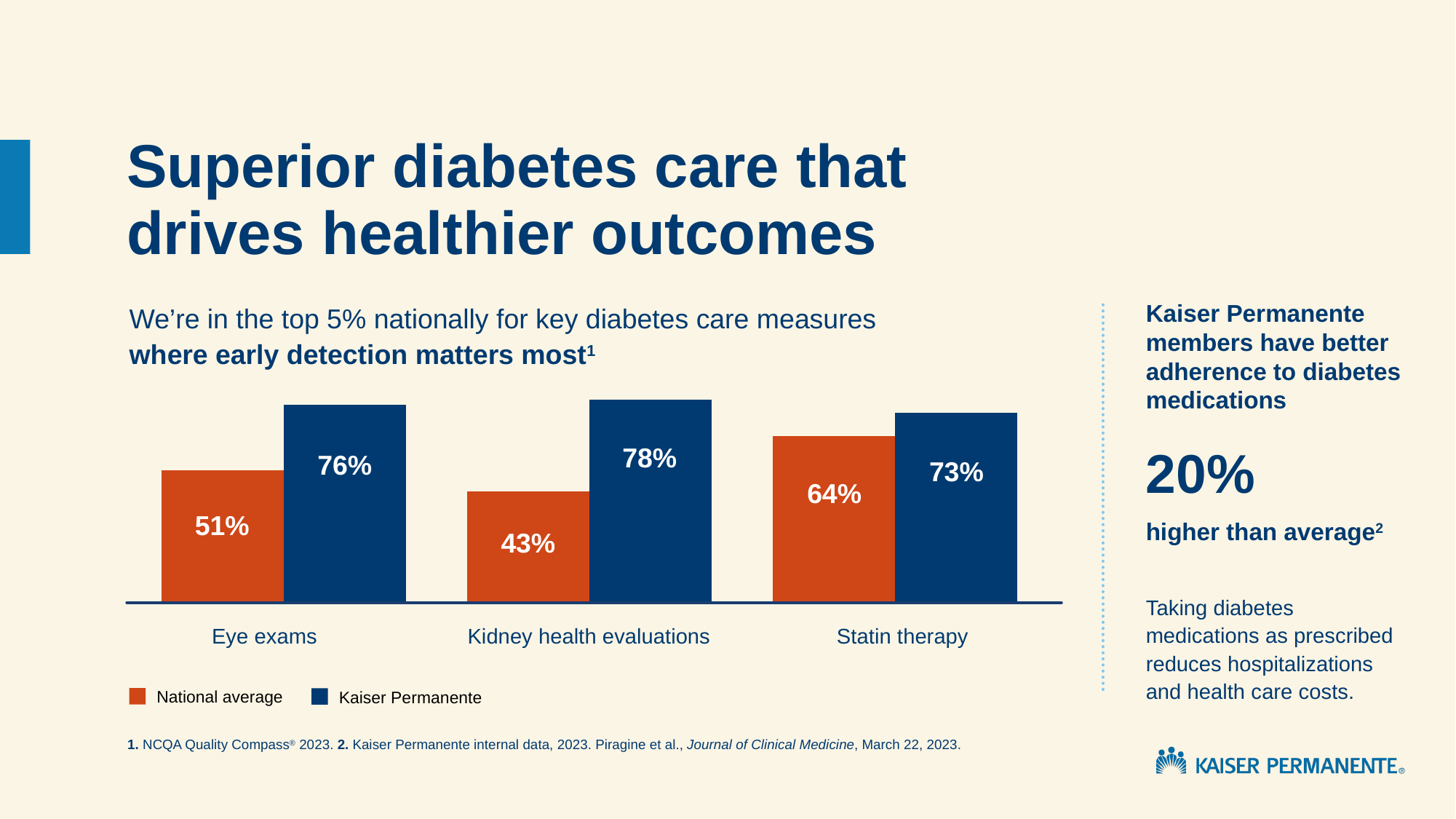
Which category has the highest Kaiser Permanente value? Kidney health evaluations What is the Kaiser Permanente value for Eye exams? 76% What kind of chart is shown on the slide? Bar chart How many categories are shown on the x axis of the chart? 3 Which colour represents the National average series in the chart? Orange What is the National average value for Statin therapy? 64% Which category has the lowest National average value? Kidney health evaluations What is the difference between the Kaiser Permanente and National average values for Kidney health evaluations? 35% How many series does the legend list? 2 What is the difference between the Kaiser Permanente and National average values for Statin therapy? 9% What is the National average value for Kidney health evaluations? 43% Which is larger: the National average for Statin therapy or the National average for Eye exams? Statin therapy